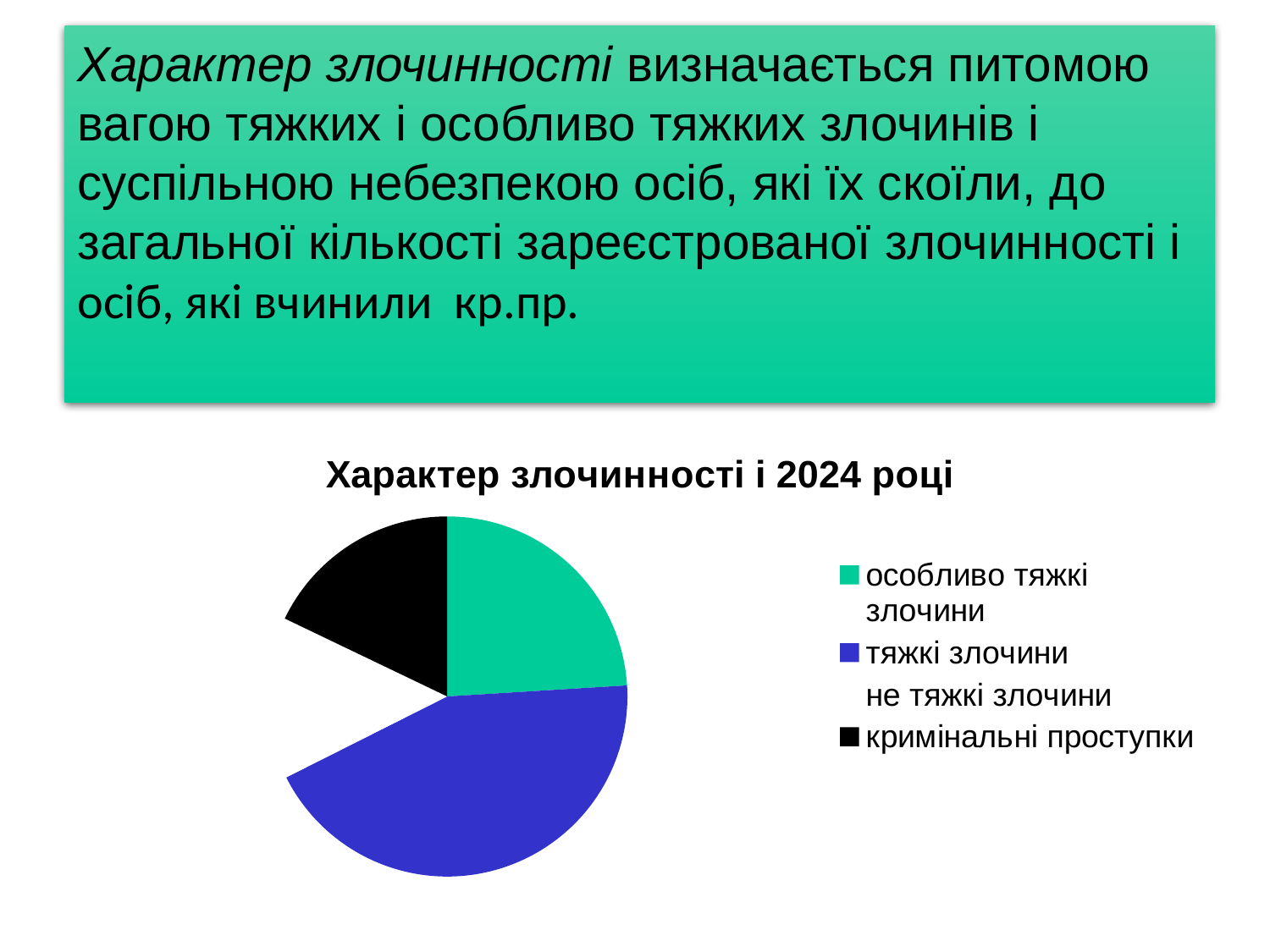
Which slice is larger: особливо тяжкі злочини or кримінальні проступки? особливо тяжкі злочини What kind of chart is shown on the slide? pie chart What colour represents тяжкі злочини in the pie chart? blue Which slice is larger: тяжкі злочини or особливо тяжкі злочини? тяжкі злочини How many entries does the chart legend list? 4 Which slice is larger: тяжкі злочини or кримінальні проступки? тяжкі злочини What is the title of the chart? Характер злочинності і 2024 році How many slices does the pie chart have? 4 Which category has the largest slice of the pie? тяжкі злочини